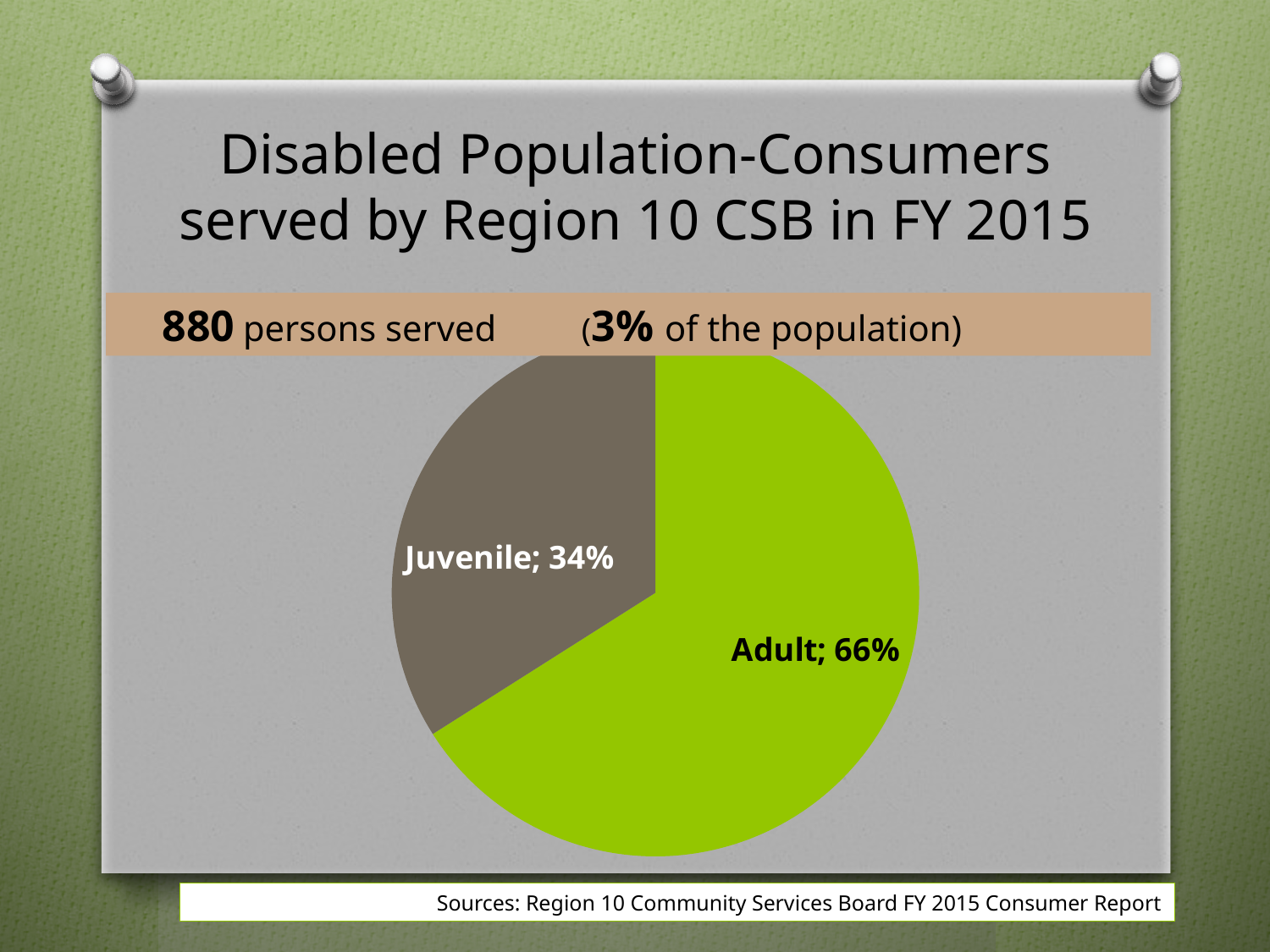
What colour is the Juvenile slice? grey What share of the pie does the Adult slice represent? 66% Which slice of the pie is the largest? Adult What is the difference in percentage points between the Adult and Juvenile slices? 32 Is the Juvenile share greater or less than 50%? less What share of the pie does the Juvenile slice represent? 34% Is the Adult share greater or less than 50%? greater How many slices does the pie chart have? 2 What colour is the Adult slice? green Which is larger, the Adult slice or the Juvenile slice? Adult What kind of chart is shown on the slide? pie chart Which slice of the pie is the smallest? Juvenile